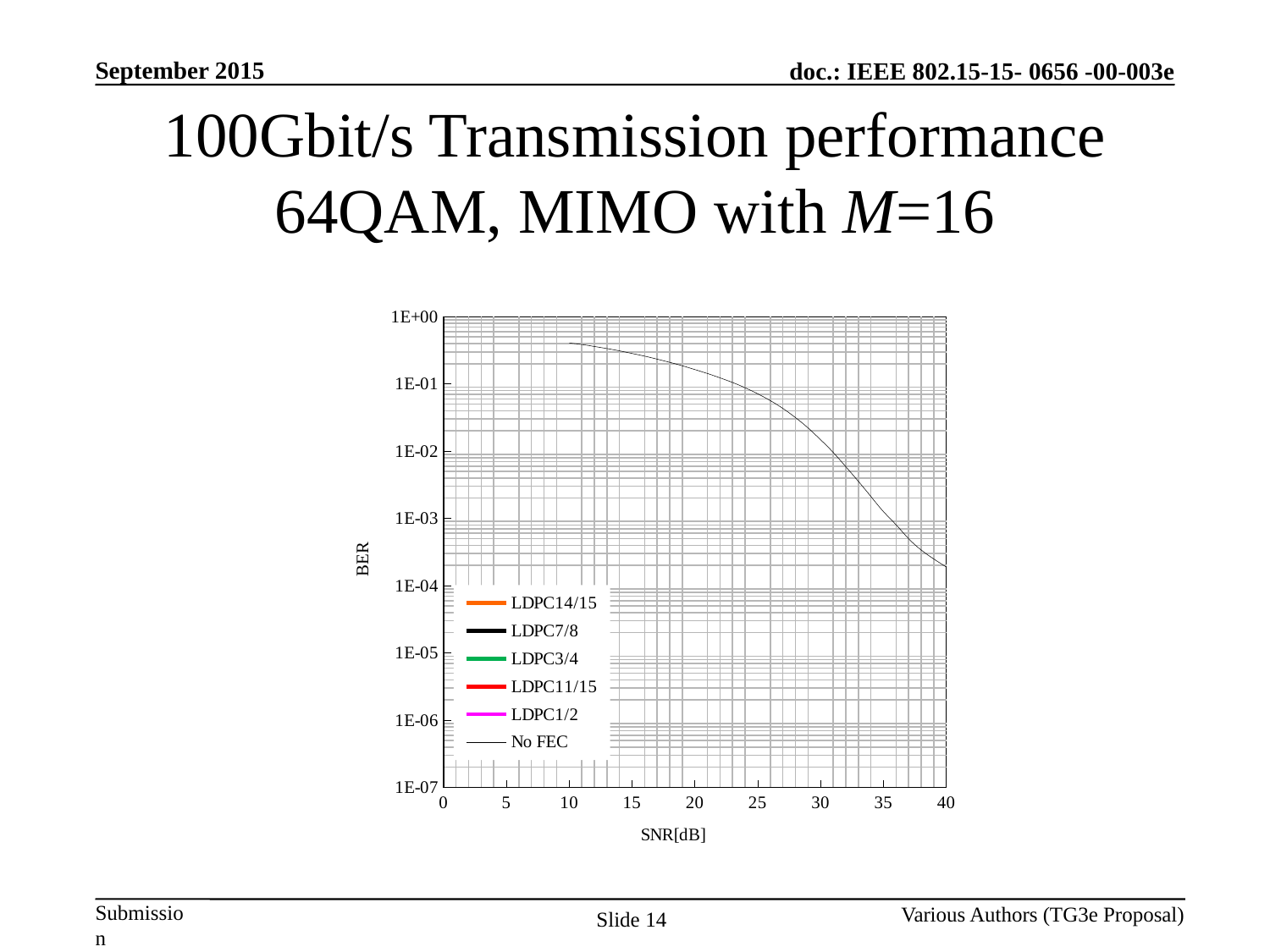
Is the BER of the No FEC curve at SNR 25 dB greater or less than 1E-01? less Is the BER of the No FEC curve at SNR 25 dB greater or less than 1E-02? greater Is the BER of the No FEC curve at SNR 30 dB greater or less than 1E-01? less What kind of chart is shown on the slide? line chart What is the label of the x axis? SNR[dB] Which legend entry is shown in orange? LDPC14/15 Does the No FEC curve rise or fall as SNR increases? fall How many series does the legend list? 6